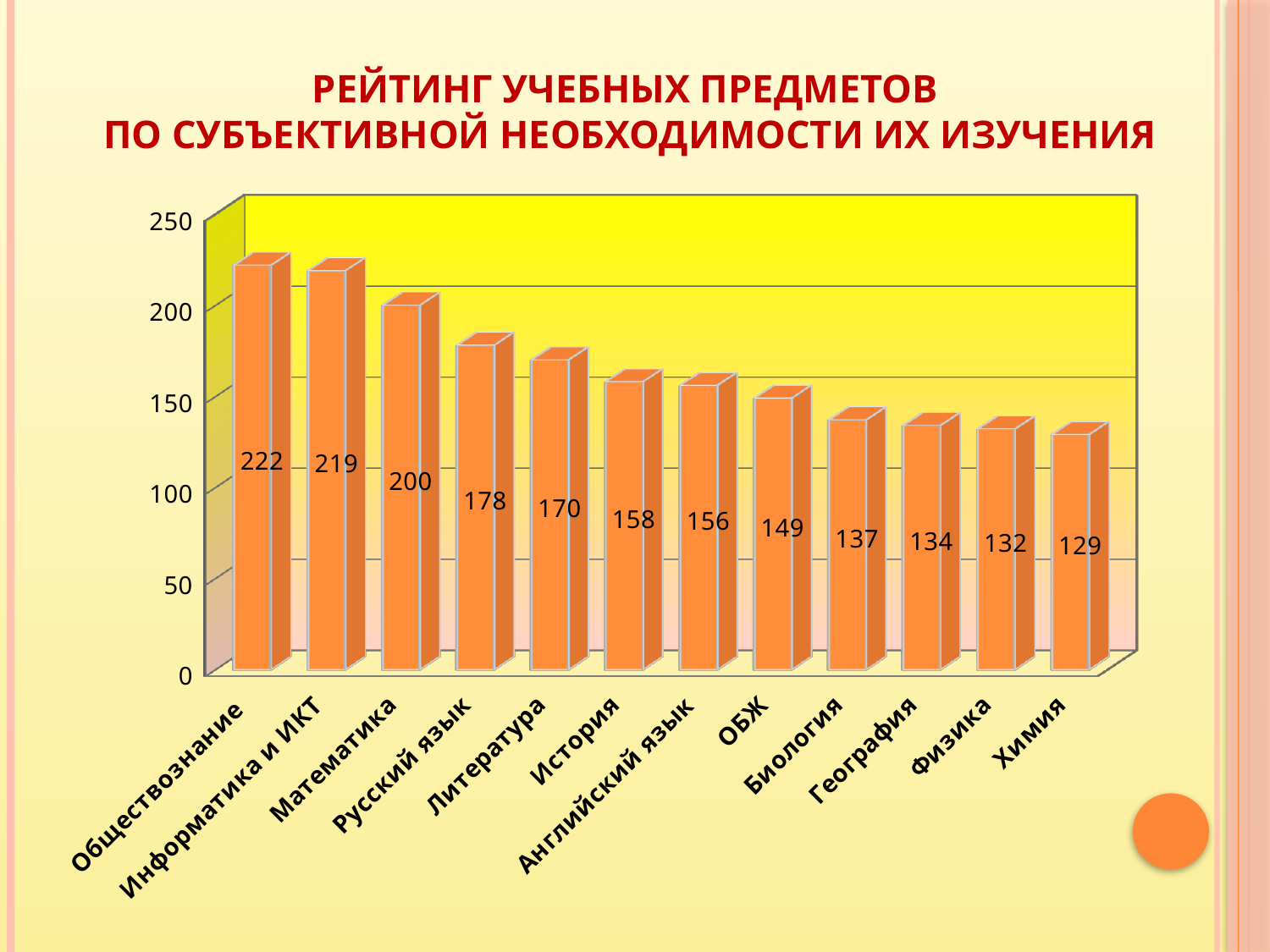
What is the value for Математика? 200 What kind of chart is shown on the slide? bar chart Which subject has the highest value? Обществознание What is the value for Химия? 129 Which is larger, the value for Литература or the value for ОБЖ? Литература What is the difference between the values for Обществознание and Информатика и ИКТ? 3 What is the value for Английский язык? 156 Do the values rise or fall from left to right along the x axis? fall How many subjects are shown in the chart? 12 Which subject has the lowest value? Химия What is the difference between the values for Русский язык and Биология? 41 Is the value for История greater or less than 150? greater